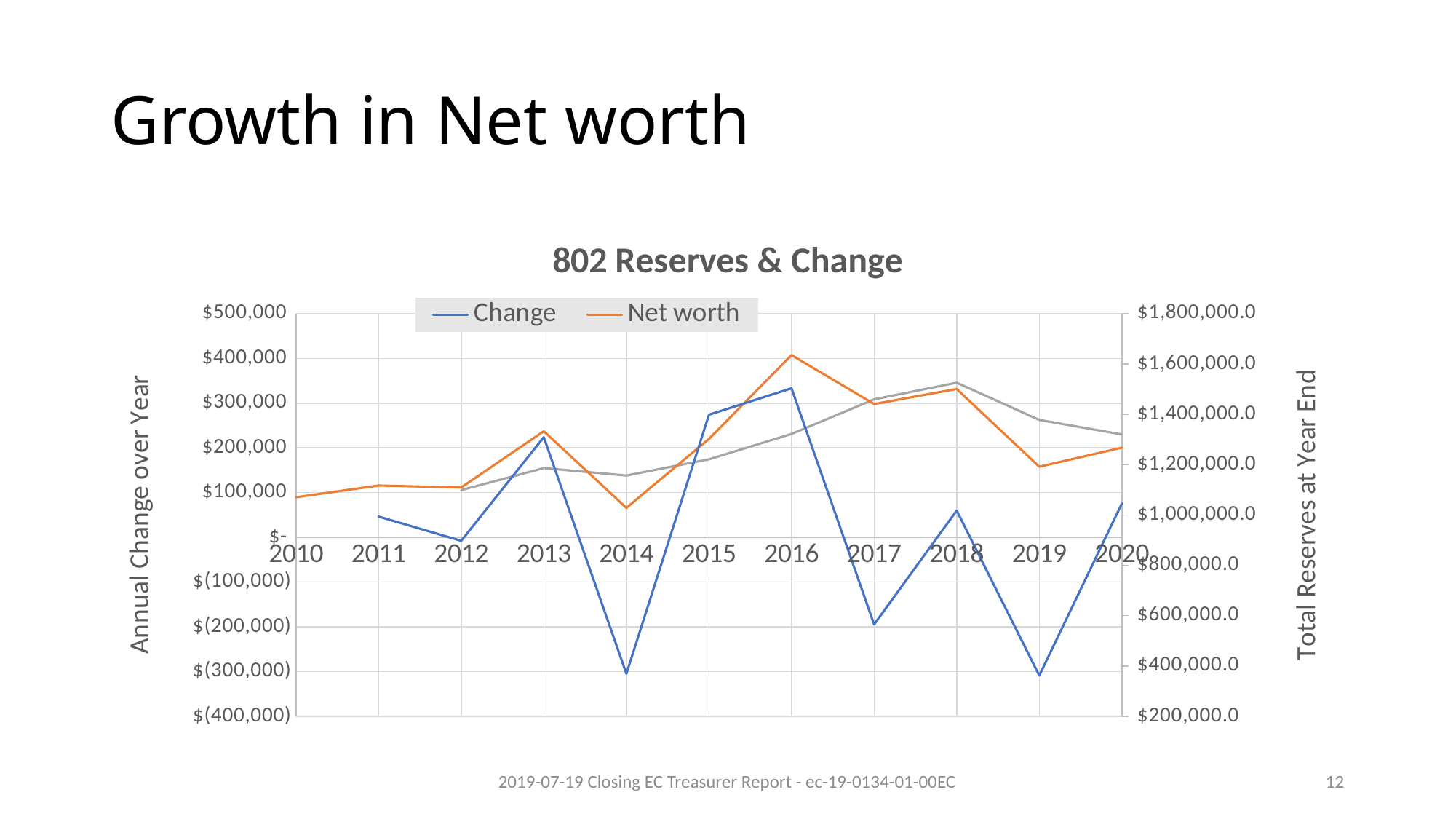
What kind of chart is the "802 Reserves & Change" chart? line chart Is the Change value for 2016 greater or less than $300,000? greater Is the Net worth value for 2019 greater or less than $1,400,000.0? less In which year does the Change series reach its highest value? 2016 How many years are shown on the x axis of the "802 Reserves & Change" chart? 11 How many series does the legend of the "802 Reserves & Change" chart list? 2 What is the label of the right-hand vertical axis of the chart? Total Reserves at Year End Does the Net worth series rise or fall from 2014 to 2016? rise Is the Change value for 2017 greater or less than $(100,000)? less In which year does the Net worth series reach its highest value? 2016 Which year has the larger Change value, 2013 or 2016? 2016